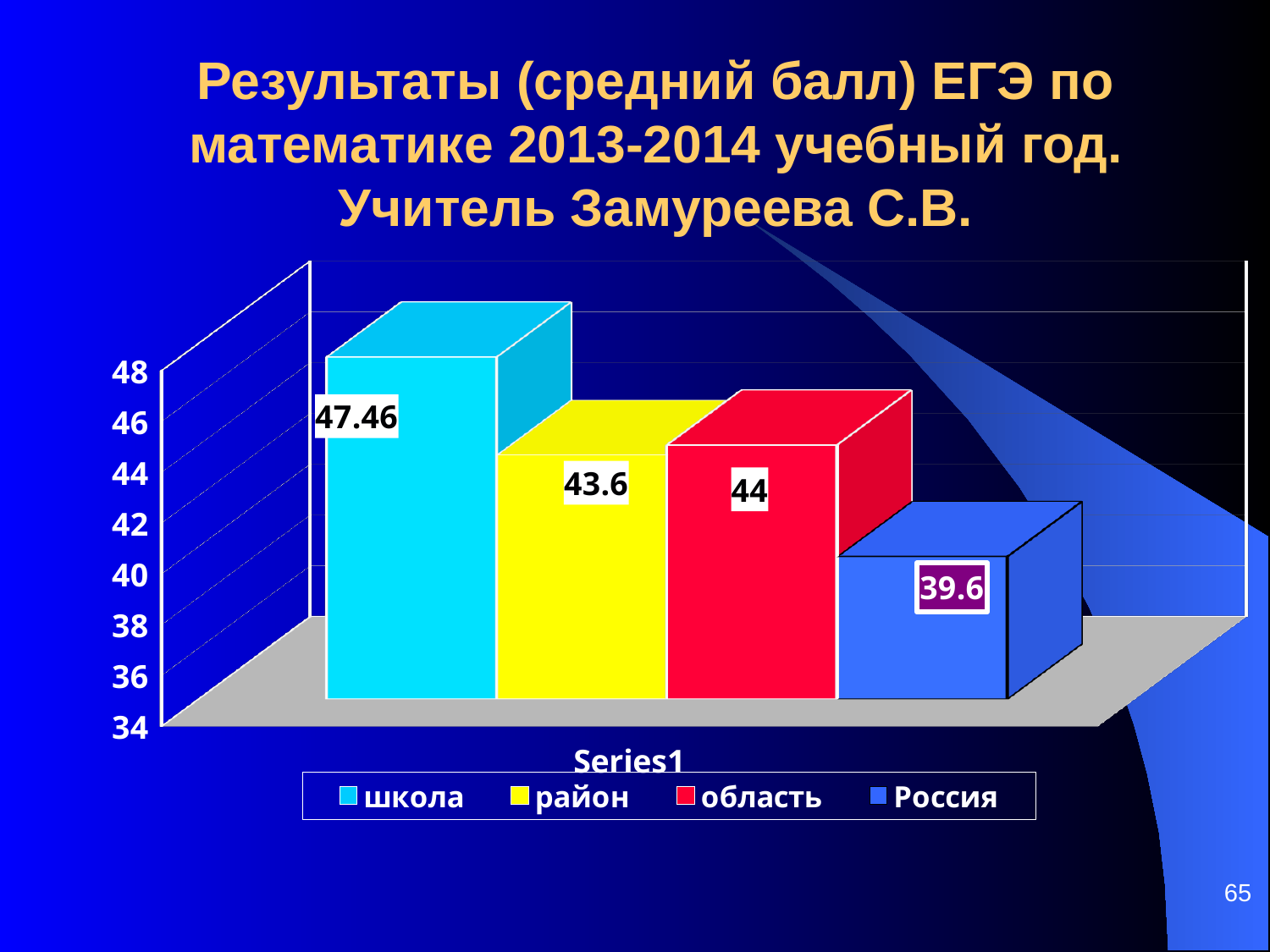
Which category has the highest value? школа What kind of chart is shown on the slide? bar chart What is the value for Россия? 39.6 Is the value for Россия greater or less than 40? less What is the value for школа? 47.46 What is the value for область? 44 What is the difference between the values for школа and Россия? 7.86 Which category has the lowest value? Россия What is the value for район? 43.6 Which is larger, the value for школа or the value for область? школа What is the difference between the values for область and район? 0.4 How many bars are plotted in the chart? 4